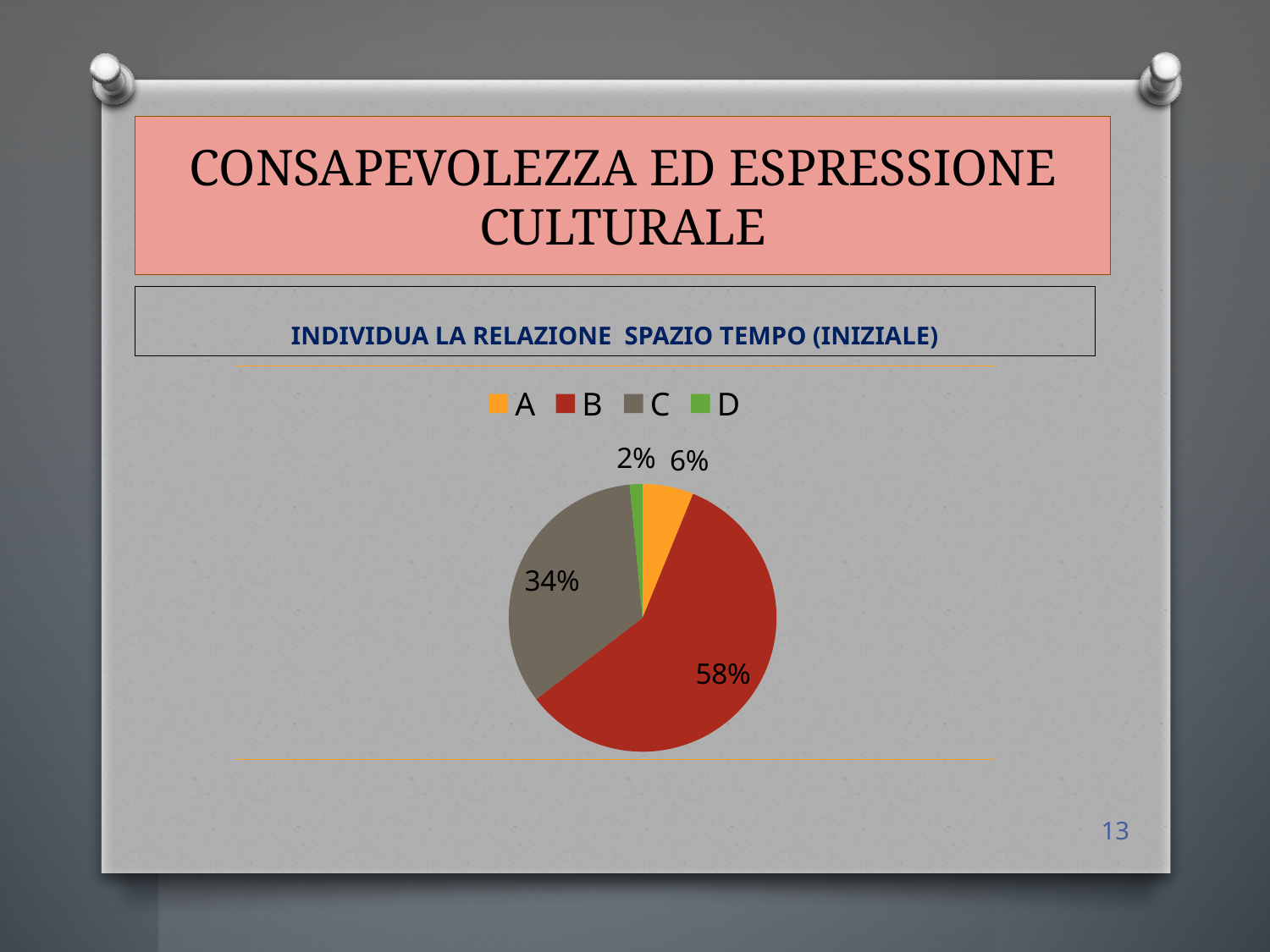
Which category has the largest slice of the pie? B Which category has the smallest slice of the pie? D What colour is the slice for category C? grey What is the difference between the shares of B and C? 24% What kind of chart is shown on the slide? pie chart What share of the pie does category D have? 2% How many categories does the legend list? 4 What share of the pie does category C have? 34% What share of the pie does category A have? 6% What is the title of the chart? INDIVIDUA LA RELAZIONE SPAZIO TEMPO (INIZIALE) Which is larger, the share of A or the share of C? C